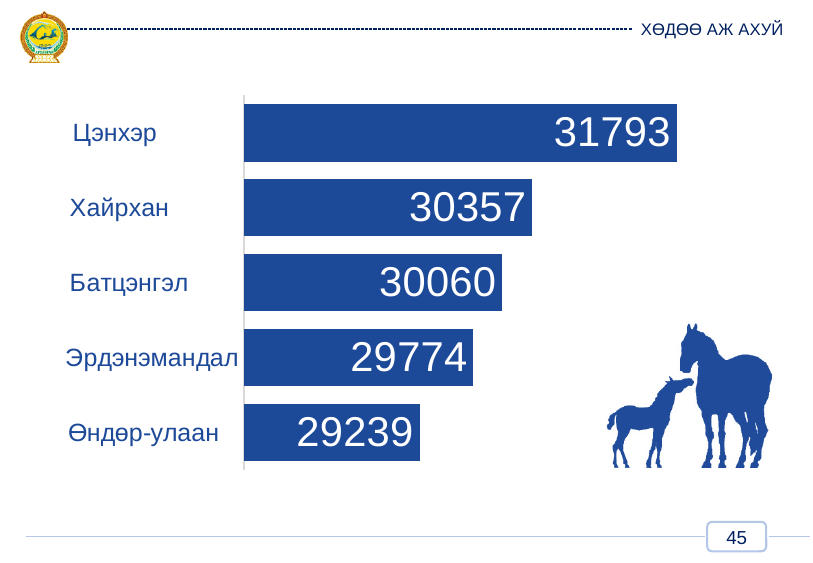
Which category has the lowest value? Өндөр-улаан What is the value for Өндөр-улаан? 29239 What is the difference between the values for Цэнхэр and Өндөр-улаан? 2554 Which category has the highest value? Цэнхэр What is the value for Батцэнгэл? 30060 What kind of chart is shown on the slide? Bar chart What is the value for Хайрхан? 30357 Which is larger, the value for Эрдэнэмандал or the value for Өндөр-улаан? Эрдэнэмандал How many categories are shown in the chart? 5 What is the value for Цэнхэр? 31793 What is the difference between the values for Хайрхан and Батцэнгэл? 297 What is the value for Эрдэнэмандал? 29774